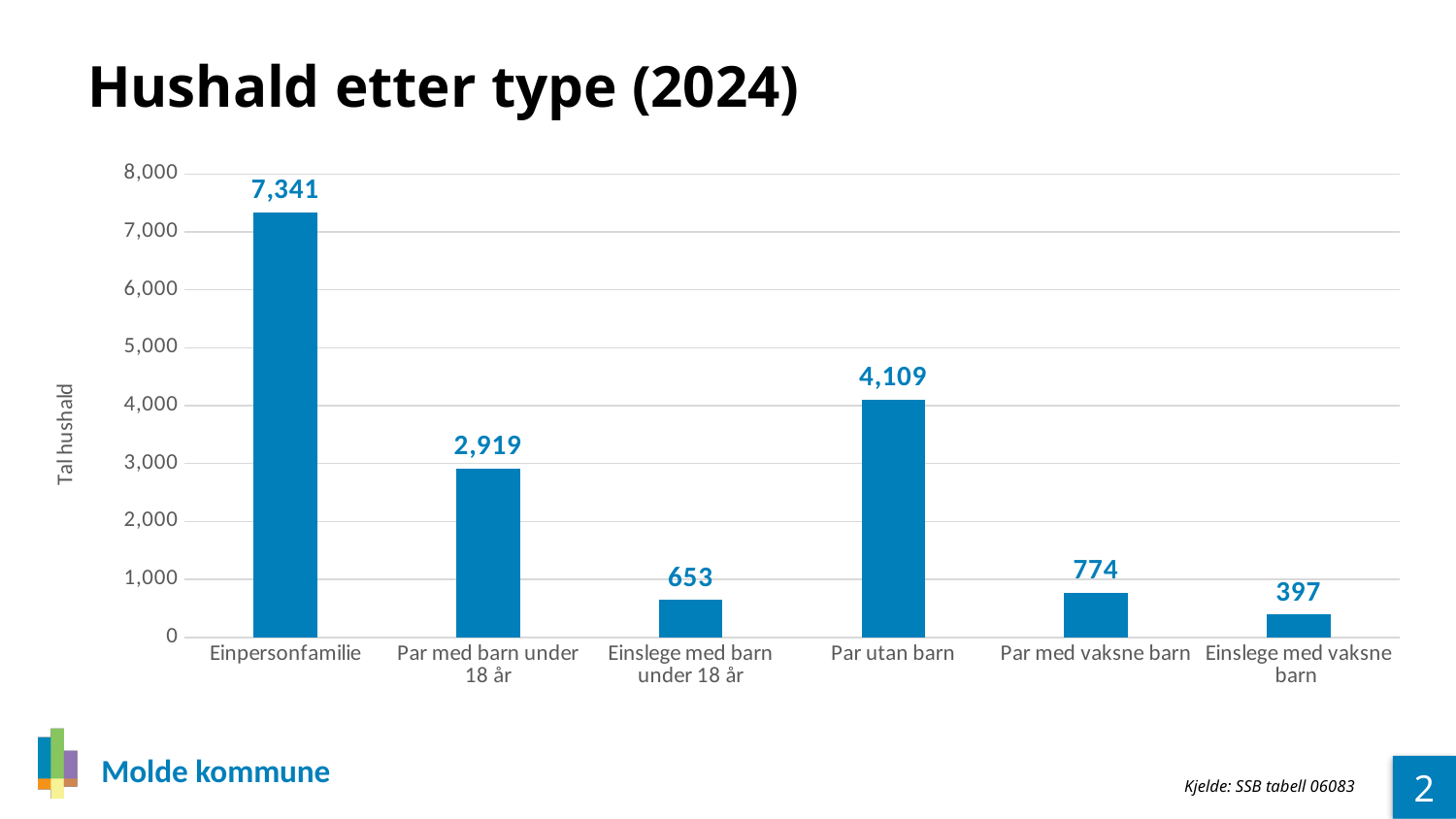
What is the value for Einpersonfamilie? 7,341 How many categories are shown on the x axis? 6 Which is larger, the value for Par med barn under 18 år or the value for Par utan barn? Par utan barn What is the value for Par utan barn? 4,109 What kind of chart is shown on the slide? bar chart Which category has the highest value? Einpersonfamilie What is the difference between the values for Einpersonfamilie and Par utan barn? 3,232 What is the value for Einslege med barn under 18 år? 653 What is the value for Par med vaksne barn? 774 What is the title of the chart? Hushald etter type (2024) Is the value for Par med barn under 18 år greater or less than 3,000? less Which category has the lowest value? Einslege med vaksne barn